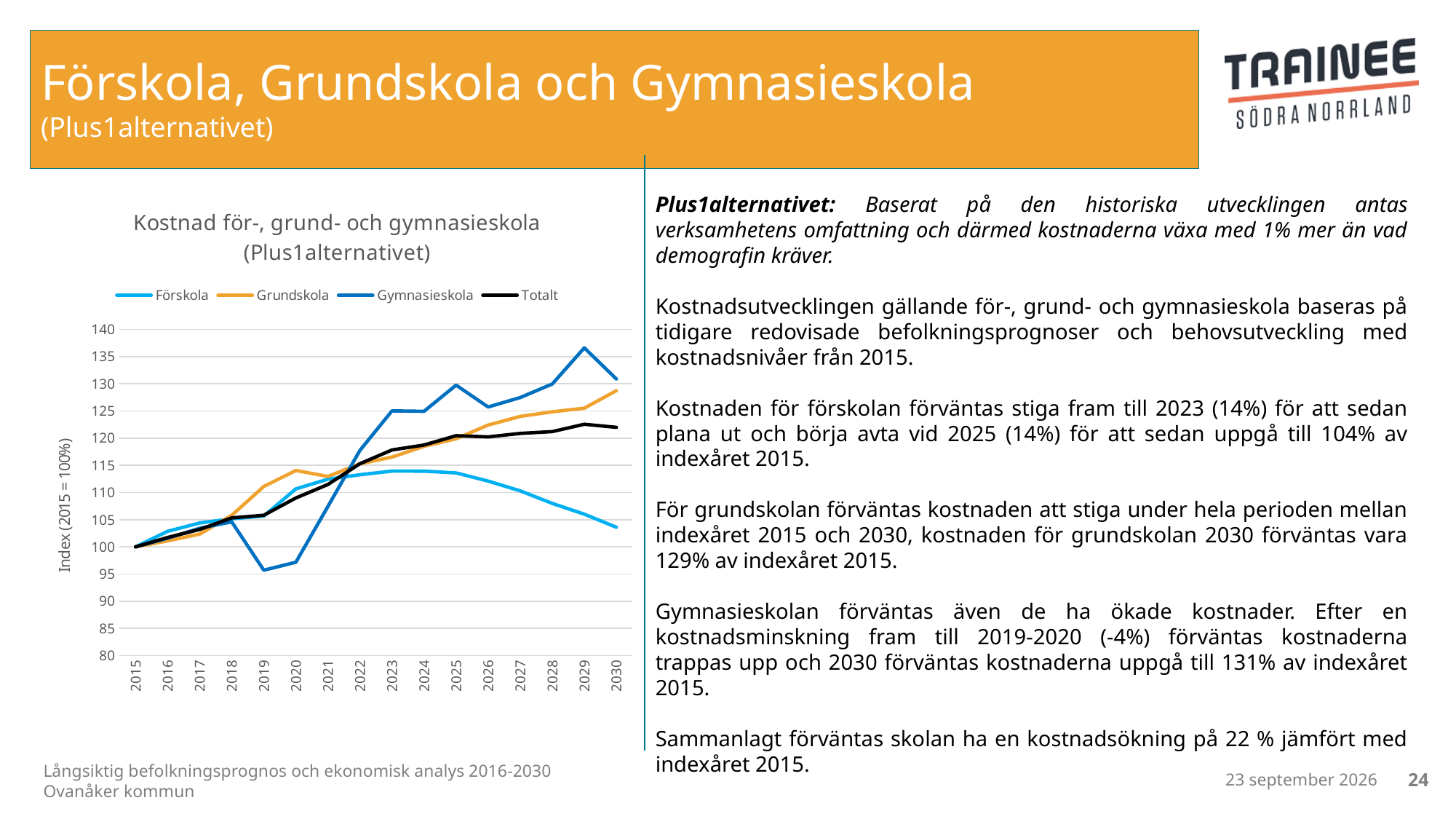
What kind of chart is shown on the slide? line chart In 2020, which is larger: the value for Grundskola or the value for Gymnasieskola? Grundskola Is the value for Gymnasieskola in 2029 greater or less than 130? greater Is the value for Förskola in 2030 greater or less than 105? less Is the value for Gymnasieskola in 2019 greater or less than 100? less Does the Förskola line rise or fall between 2025 and 2030? fall How many years are plotted along the x axis of the chart? 16 Which series has the lowest value in 2030? Förskola Which series has the highest value in 2030? Gymnasieskola How many series does the legend of the chart list? 4 What is the index value for Totalt in 2015? 100